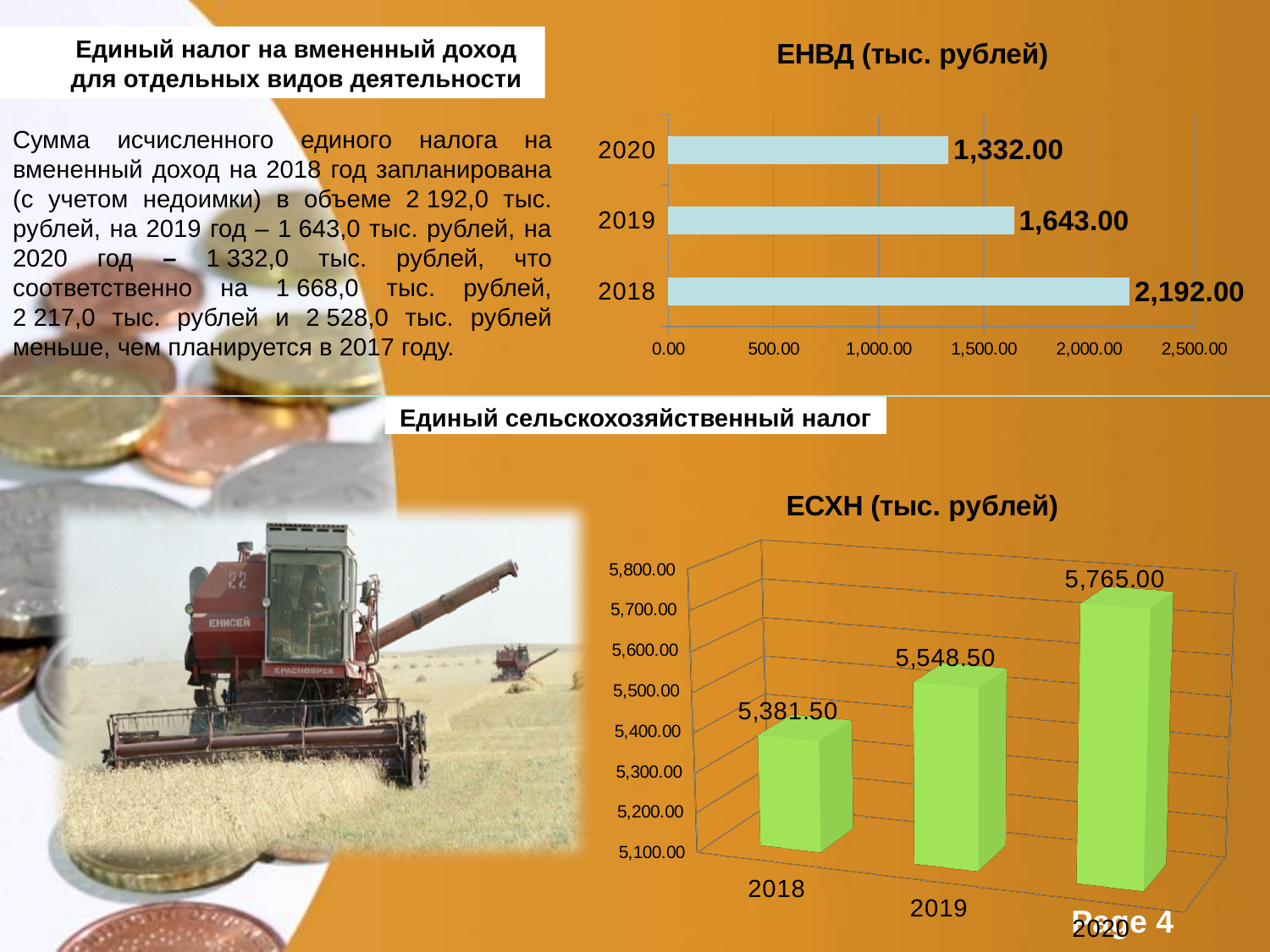
In the ЕСХН (тыс. рублей) chart, do the values rise or fall from 2018 to 2020? Rise In the ЕНВД (тыс. рублей) chart, what is the value for 2020? 1,332.00 In the ЕСХН (тыс. рублей) chart, what is the difference between the values for 2020 and 2018? 383.50 What kind of chart is the ЕНВД (тыс. рублей) chart? Bar chart In the ЕСХН (тыс. рублей) chart, is the value for 2018 greater or less than 5,400.00? less In the ЕСХН (тыс. рублей) chart, what is the value for 2019? 5,548.50 In the ЕНВД (тыс. рублей) chart, what is the value for 2018? 2,192.00 In the ЕСХН (тыс. рублей) chart, what is the value for 2020? 5,765.00 In the ЕНВД (тыс. рублей) chart, how many years are shown? 3 In the ЕСХН (тыс. рублей) chart, which year has the highest value? 2020 In the ЕНВД (тыс. рублей) chart, what is the difference between the values for 2018 and 2019? 549.00 In the ЕНВД (тыс. рублей) chart, which year has the lowest value? 2020